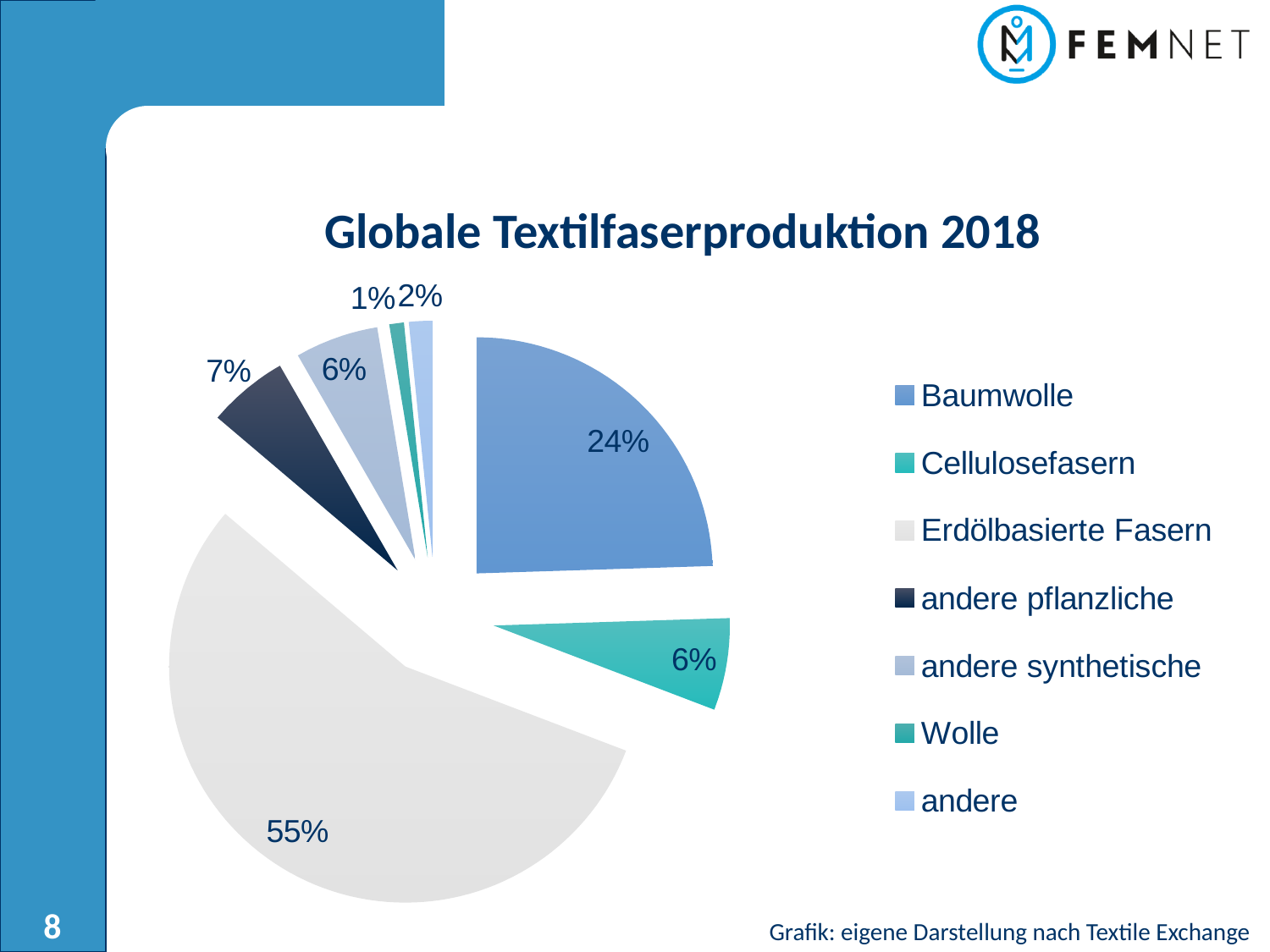
What share of the pie does Wolle have? 1% What share of the pie does Baumwolle have? 24% What share of the pie does andere have? 2% Which category has the largest share of the pie? Erdölbasierte Fasern Which category has the smallest share of the pie? Wolle Which has a larger share, Baumwolle or andere pflanzliche? Baumwolle What is the difference in percentage points between Erdölbasierte Fasern and Baumwolle? 31 What type of chart is shown on the slide? pie chart What is the title of the pie chart? Globale Textilfaserproduktion 2018 How many categories does the legend list? 7